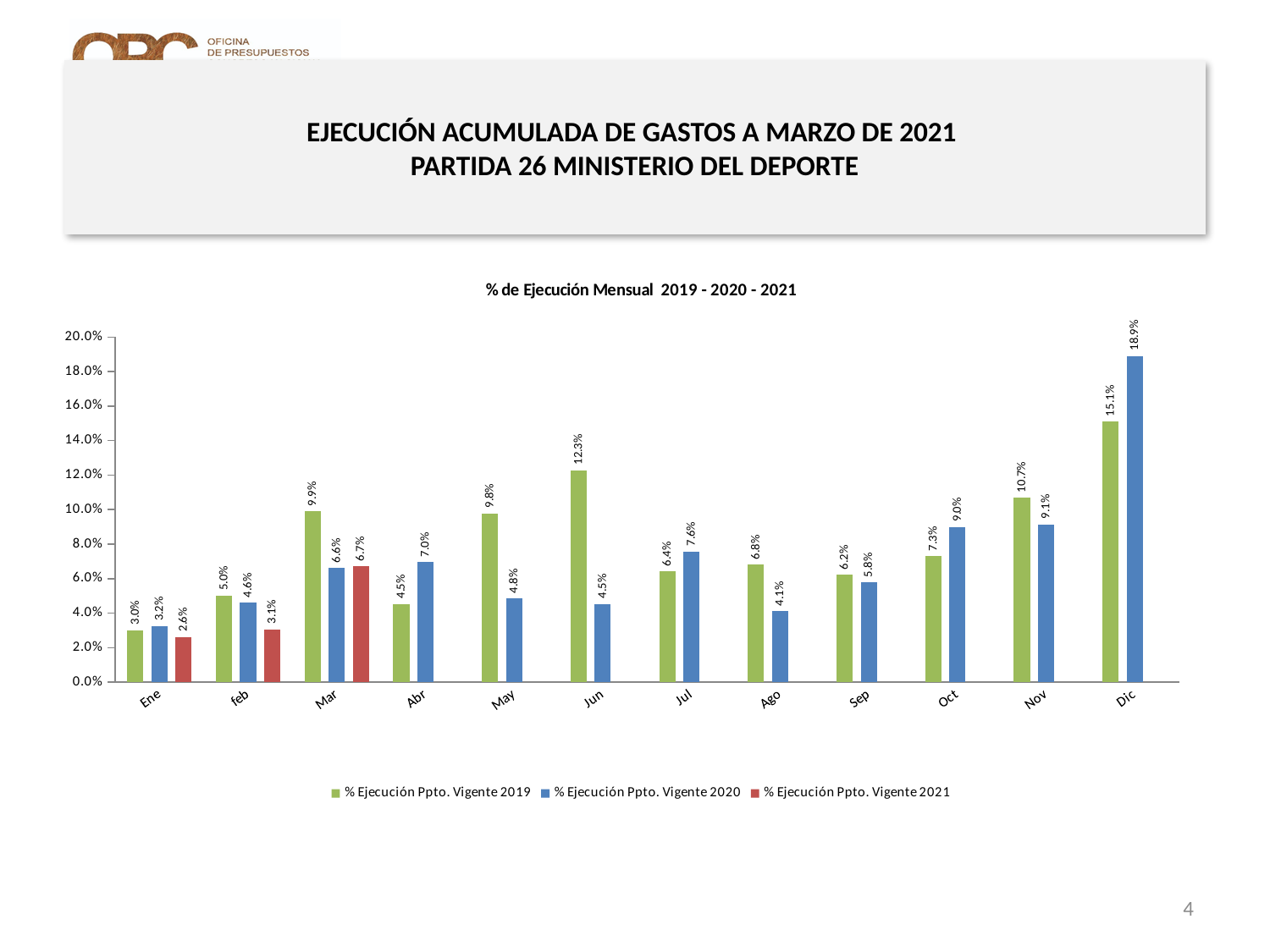
How many months are shown on the x axis? 12 What is the value for % Ejecución Ppto. Vigente 2019 in Jun? 12.3% Is the value for % Ejecución Ppto. Vigente 2019 in Nov greater or less than 10.0%? greater In which month is the % Ejecución Ppto. Vigente 2020 value lowest? Ene What type of chart is shown on the slide? bar chart Which is larger in Oct: the 2019 value or the 2020 value? 2020 What is the value for % Ejecución Ppto. Vigente 2021 in Mar? 6.7% In which month is the % Ejecución Ppto. Vigente 2019 value highest? Dic What is the value for % Ejecución Ppto. Vigente 2020 in Dic? 18.9% What is the difference between the 2019 and 2020 values in Mar? 3.3% How many series does the legend list? 3 What is the title of the chart? % de Ejecución Mensual 2019 - 2020 - 2021